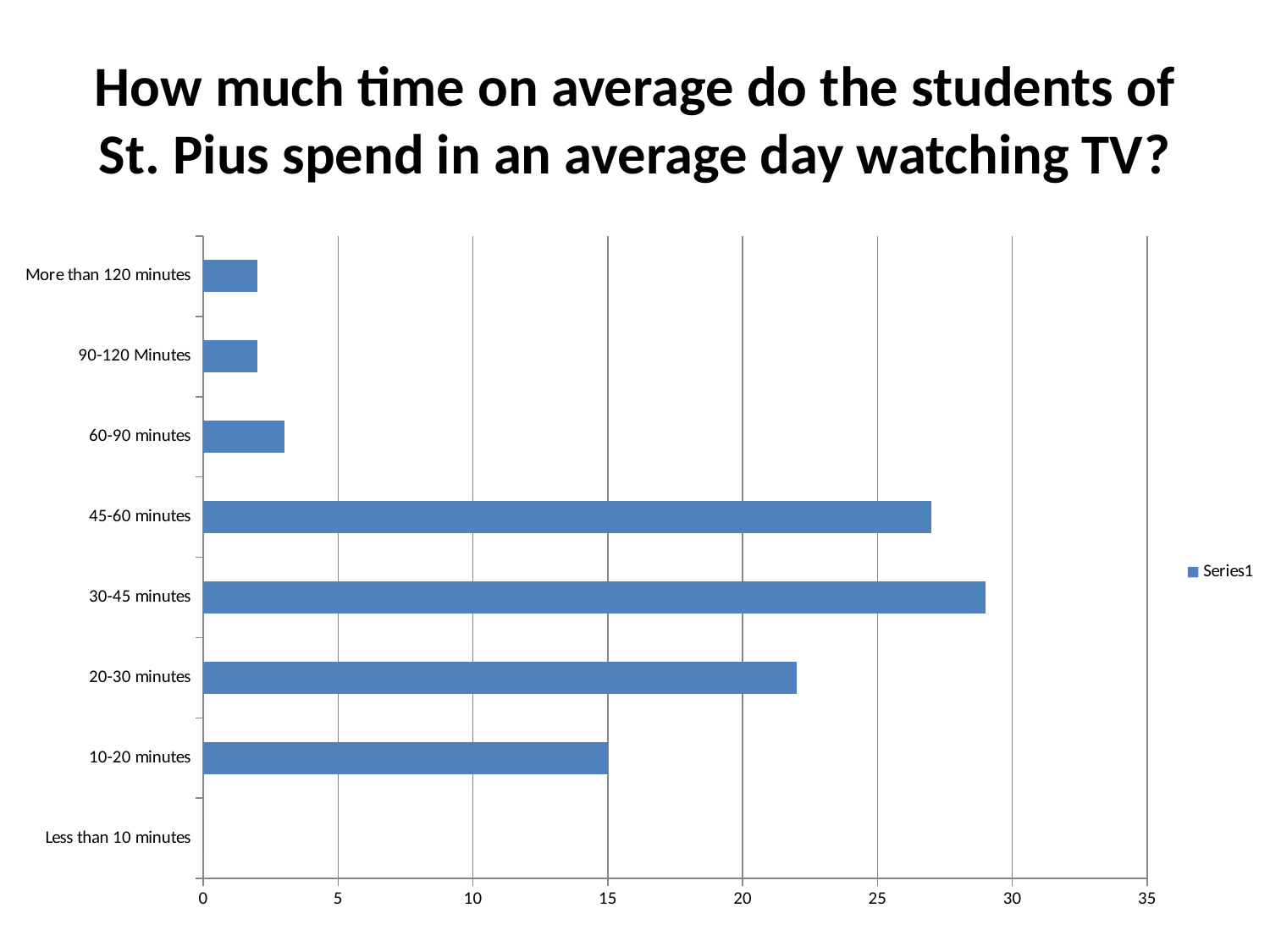
Is the value for 45-60 minutes greater or less than 25? greater Is the value for 20-30 minutes greater or less than 20? greater How many series does the legend list? 1 Is the value for 60-90 minutes greater or less than 5? less Which is larger, the value for 45-60 minutes or the value for 20-30 minutes? 45-60 minutes Which category has the lowest value? Less than 10 minutes How many categories are shown on the chart? 8 What is the value for Less than 10 minutes? 0 Which category has the highest value? 30-45 minutes What is the value for 10-20 minutes? 15 What kind of chart is shown on the slide? bar chart What is the name of the series shown in the legend? Series1